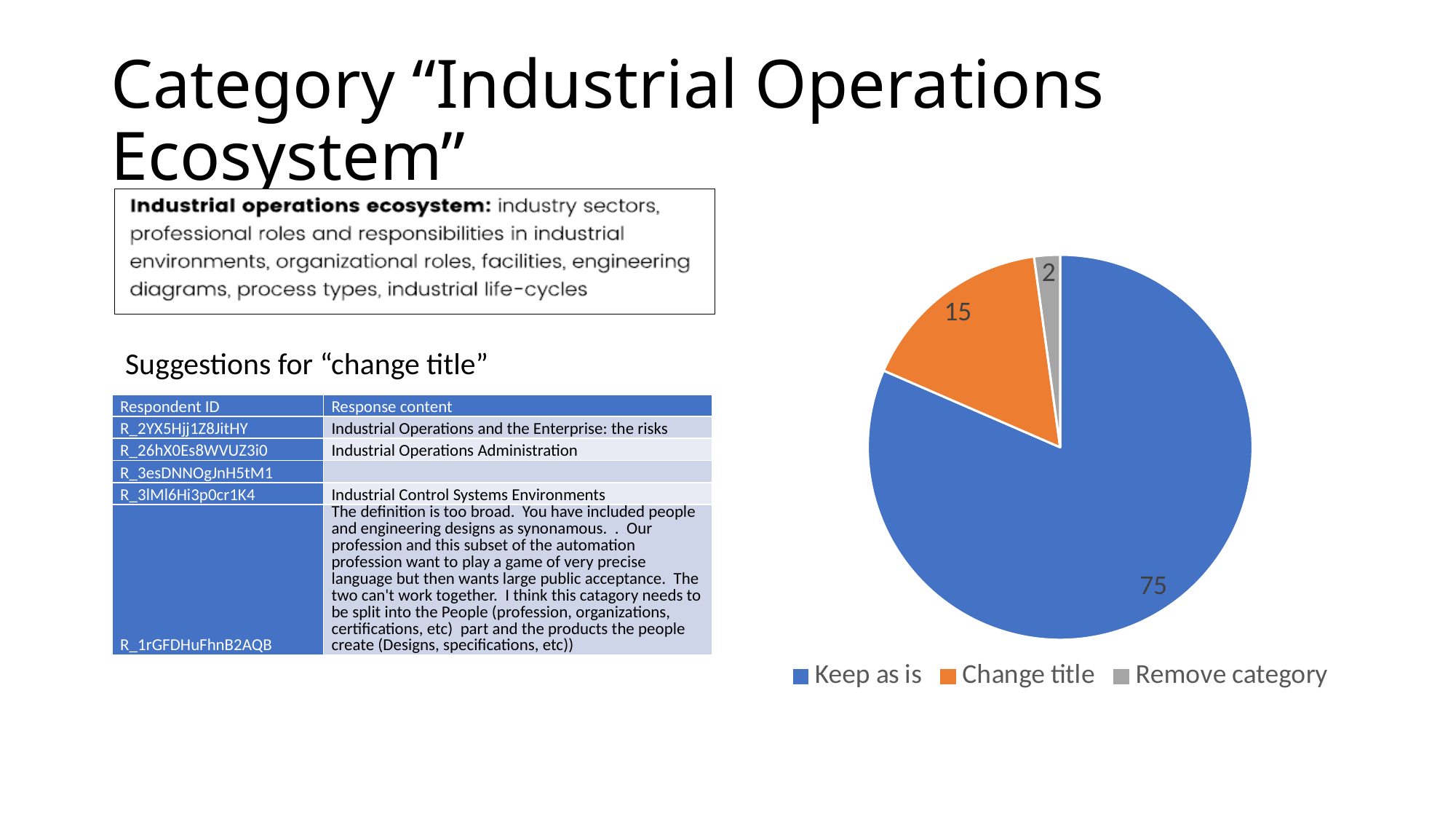
What type of chart is shown on the slide? Pie chart What is the total of all the values shown in the pie chart? 92 What is the value for "Remove category" in the pie chart? 2 What is the value for "Keep as is" in the pie chart? 75 What is the difference between the values for "Keep as is" and "Change title"? 60 Which category has the largest slice in the pie chart? Keep as is What is the value for "Change title" in the pie chart? 15 What is the difference between the values for "Change title" and "Remove category"? 13 Which colour represents "Change title" in the pie chart? Orange Which is larger, the value for "Change title" or the value for "Remove category"? Change title How many slices does the pie chart have? 3 Which category has the smallest slice in the pie chart? Remove category